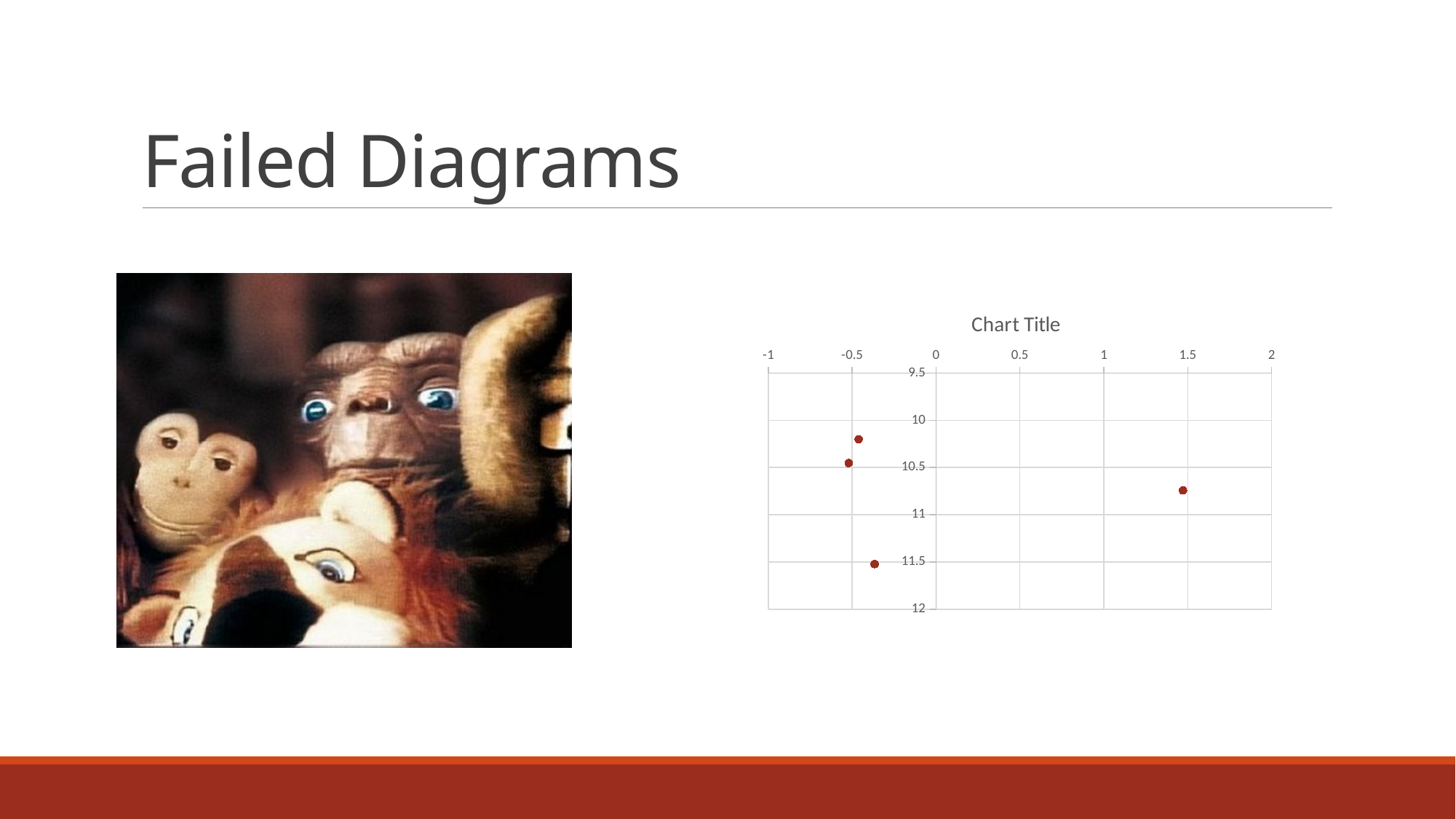
Is the y value of the rightmost point greater or less than 11? less How many data points are plotted on the chart? 4 What is the lowest value shown on the x axis of the chart? -1 Is the y value of the point plotted highest on the chart greater or less than 10.5? less How many of the plotted points have a negative x value? 3 Is the x value of the rightmost point greater or less than 2? less What kind of chart is shown on the slide? scatter chart How many of the plotted points have a positive x value? 1 What is the title of the chart? Chart Title